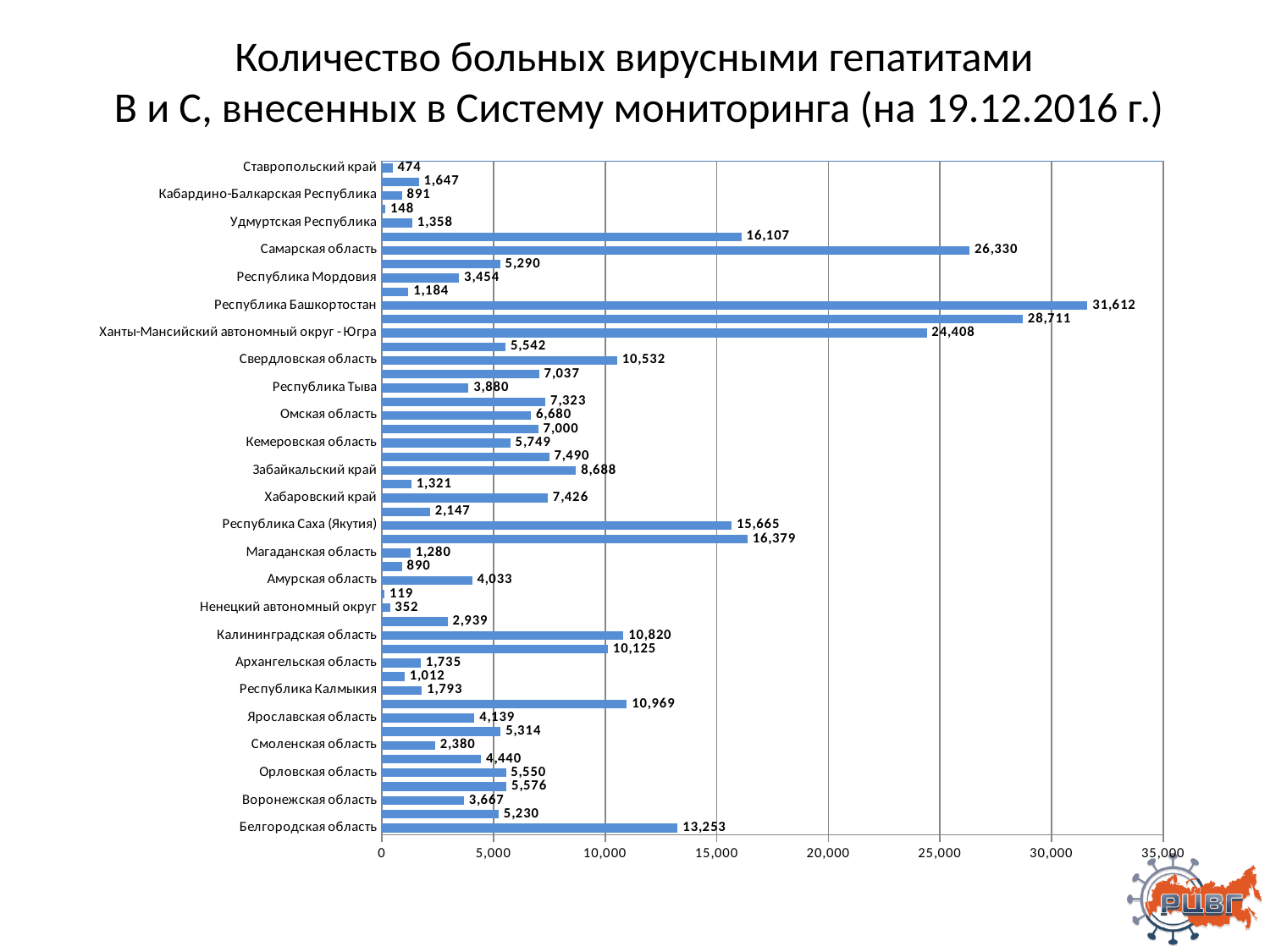
Which labeled region has the highest value? Республика Башкортостан Which is larger, the value for Калининградская область or the value for Свердловская область? Калининградская область What is the value for Республика Башкортостан? 31,612 What is the value for Ханты-Мансийский автономный округ - Югра? 24,408 What is the maximum value shown on the horizontal axis? 35,000 What is the value for Ненецкий автономный округ? 352 What is the difference between the values for Самарская область and Ханты-Мансийский автономный округ - Югра? 1,922 What is the value for Белгородская область? 13,253 What is the value for Самарская область? 26,330 What type of chart is shown on the slide? bar chart What is the smallest value printed on the chart? 119 Is the value for Республика Саха (Якутия) greater or less than 15,000? greater